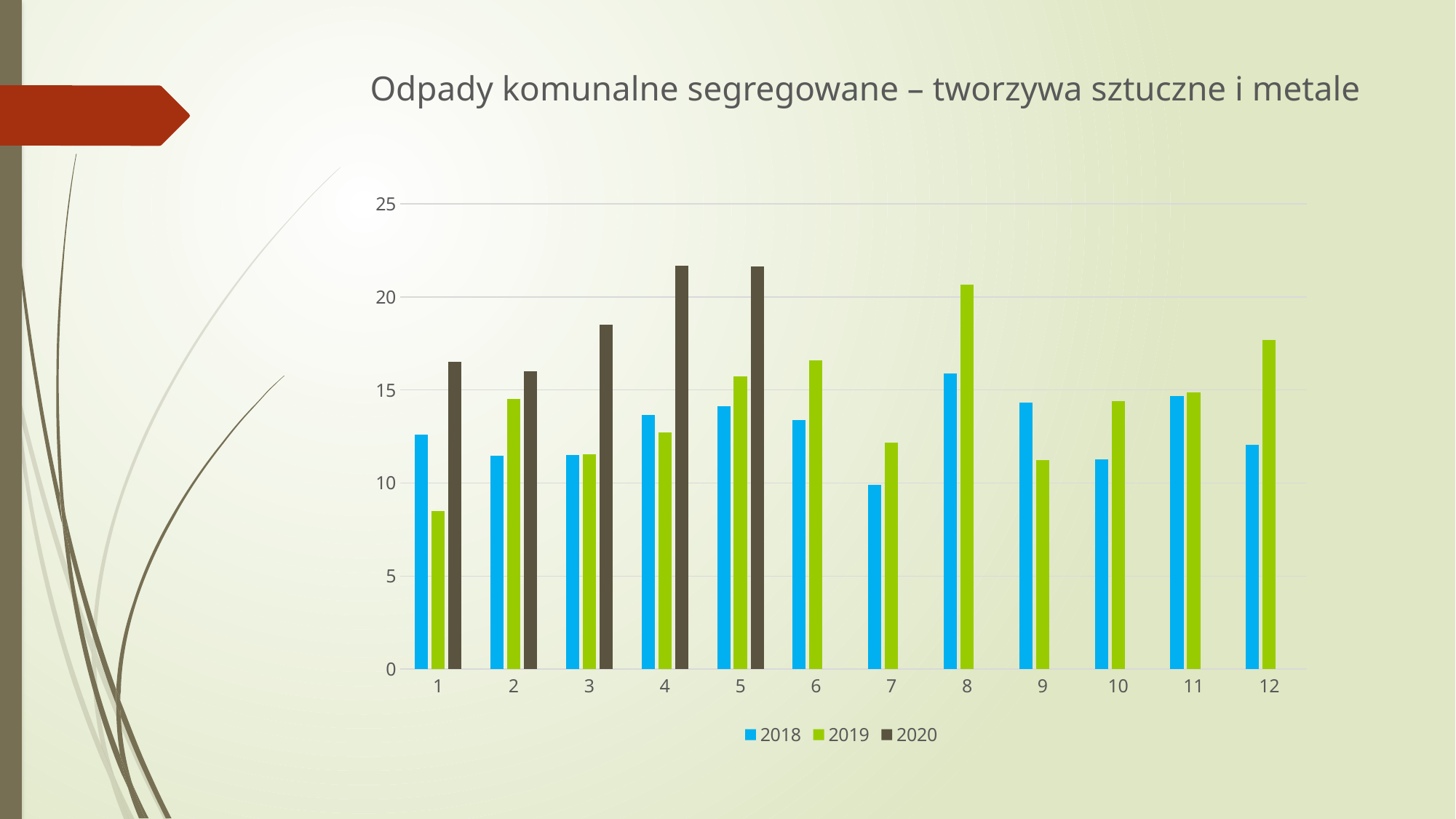
In category 12, which series has the larger value, 2018 or 2019? 2019 How many series does the legend list? 3 In category 1, which series has the larger value, 2018 or 2020? 2020 How many categories are shown on the x axis? 12 Is the value for 2020 in category 4 greater or less than 20? greater Which category has the lowest value for the 2019 series? 1 What is the title of the chart? Odpady komunalne segregowane – tworzywa sztuczne i metale Which category has the lowest value for the 2018 series? 7 Is the value for 2019 in category 8 greater or less than 20? greater Which category has the highest value for the 2019 series? 8 What type of chart is shown on the slide? bar chart